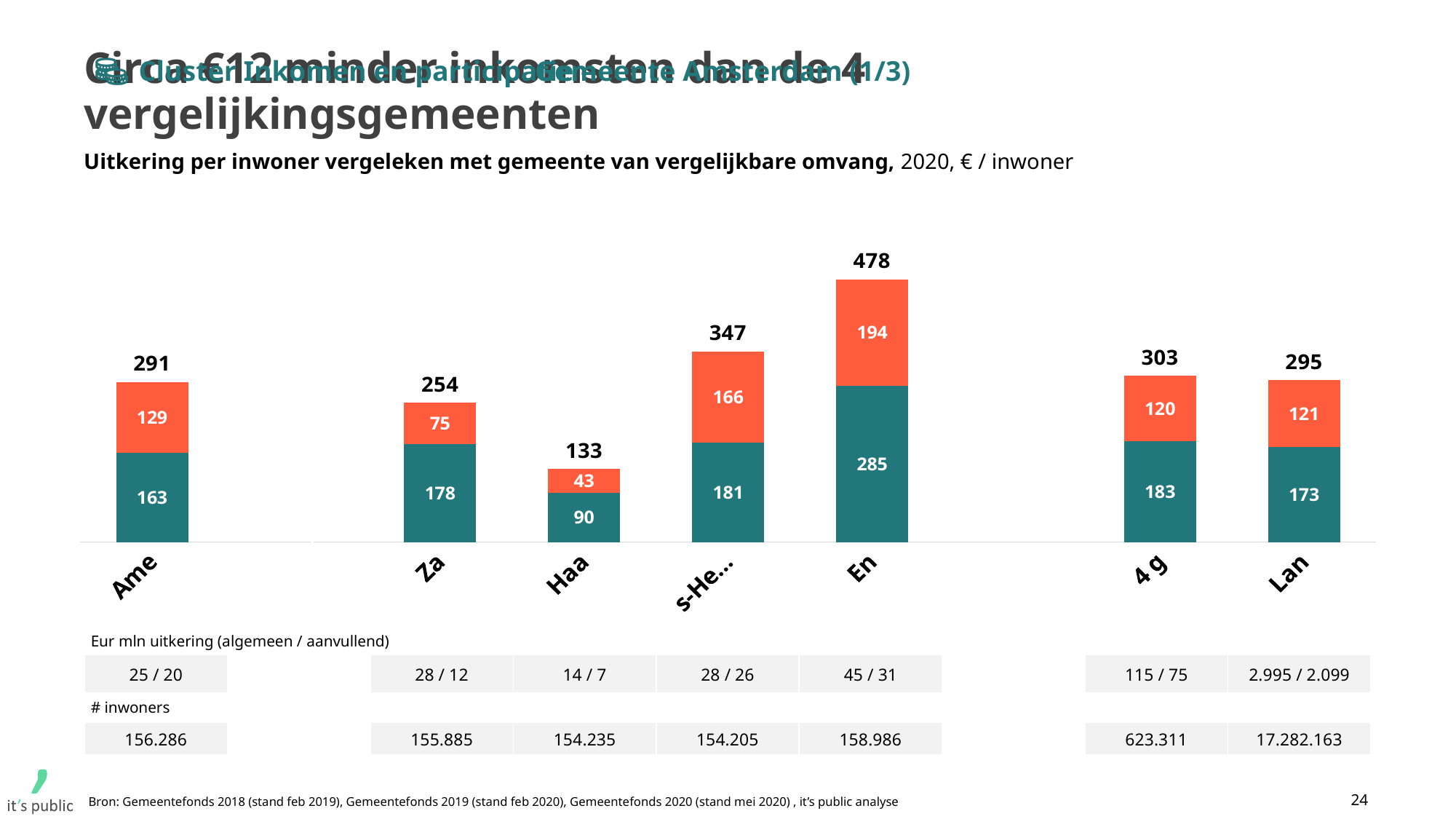
What is the value of the orange (top) segment for Haa? 43 How many categories are shown on the x axis? 7 Which has a larger total, 4 g or Lan? 4 g What unit is stated in the chart subtitle? € / inwoner What kind of chart is shown on the slide? Stacked bar chart What is the difference between the teal segment and the orange segment for Lan? 52 What is the total value of the bar for Ame? 291 What is the value of the teal (bottom) segment for En? 285 What is the difference between the total for En and the total for Ame? 187 Which category has the highest total bar? En What is the value of the orange (top) segment for Za? 75 Which category has the lowest total bar? Haa